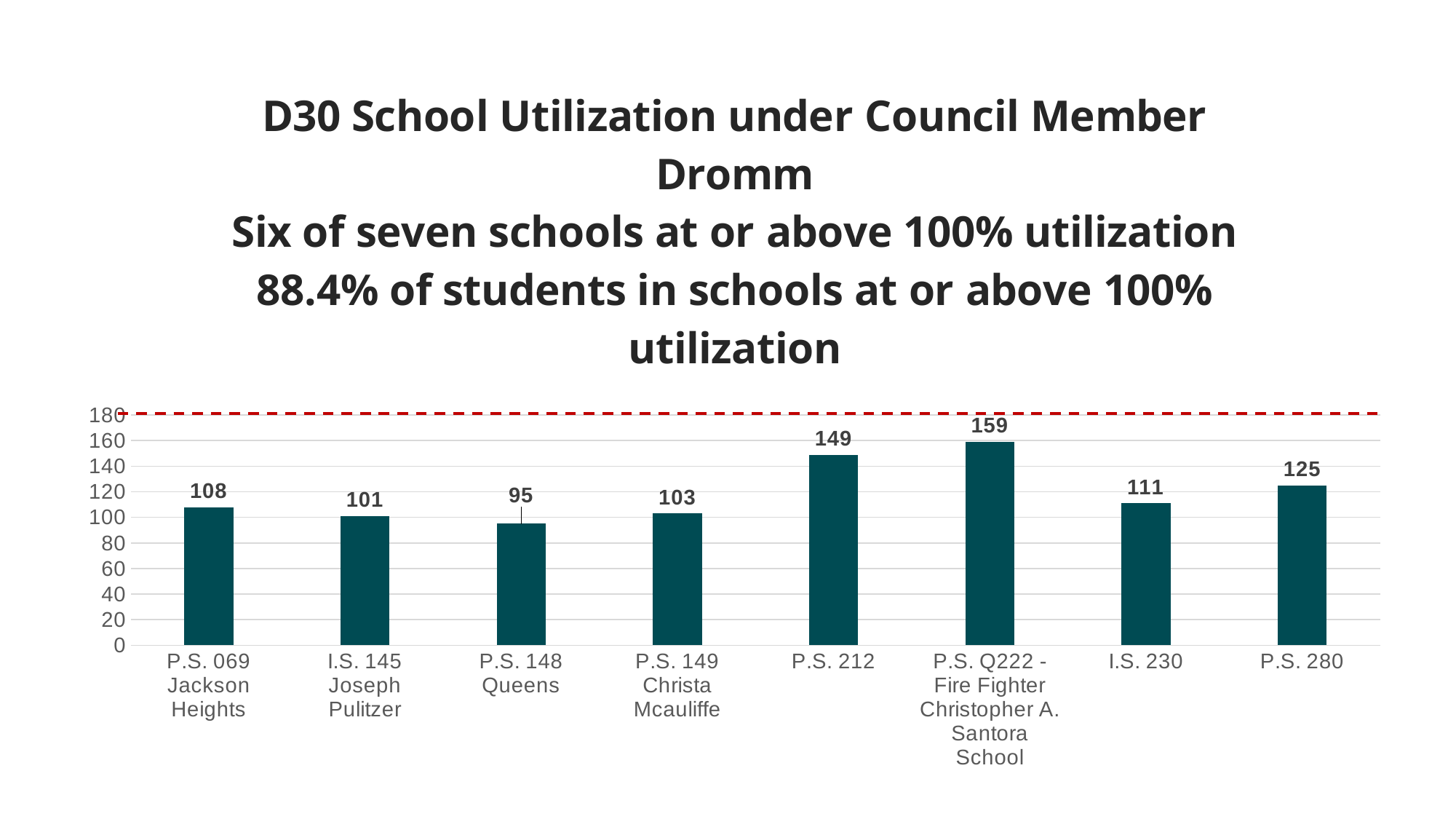
What is the difference between the values for P.S. Q222 - Fire Fighter Christopher A. Santora School and P.S. 148 Queens? 64 What is the difference between the values for P.S. 212 and I.S. 230? 38 What is the value for I.S. 145 Joseph Pulitzer? 101 What is the value for P.S. 212? 149 How many schools are shown on the chart? 8 What kind of chart is shown on the slide? bar chart Is the value for P.S. 280 greater or less than 120? greater Which is larger, the value for P.S. 069 Jackson Heights or the value for P.S. 149 Christa Mcauliffe? P.S. 069 Jackson Heights What is the value for P.S. 280? 125 What is the highest value labelled on the vertical axis? 180 Which school has the highest value? P.S. Q222 - Fire Fighter Christopher A. Santora School Which school has the lowest value? P.S. 148 Queens